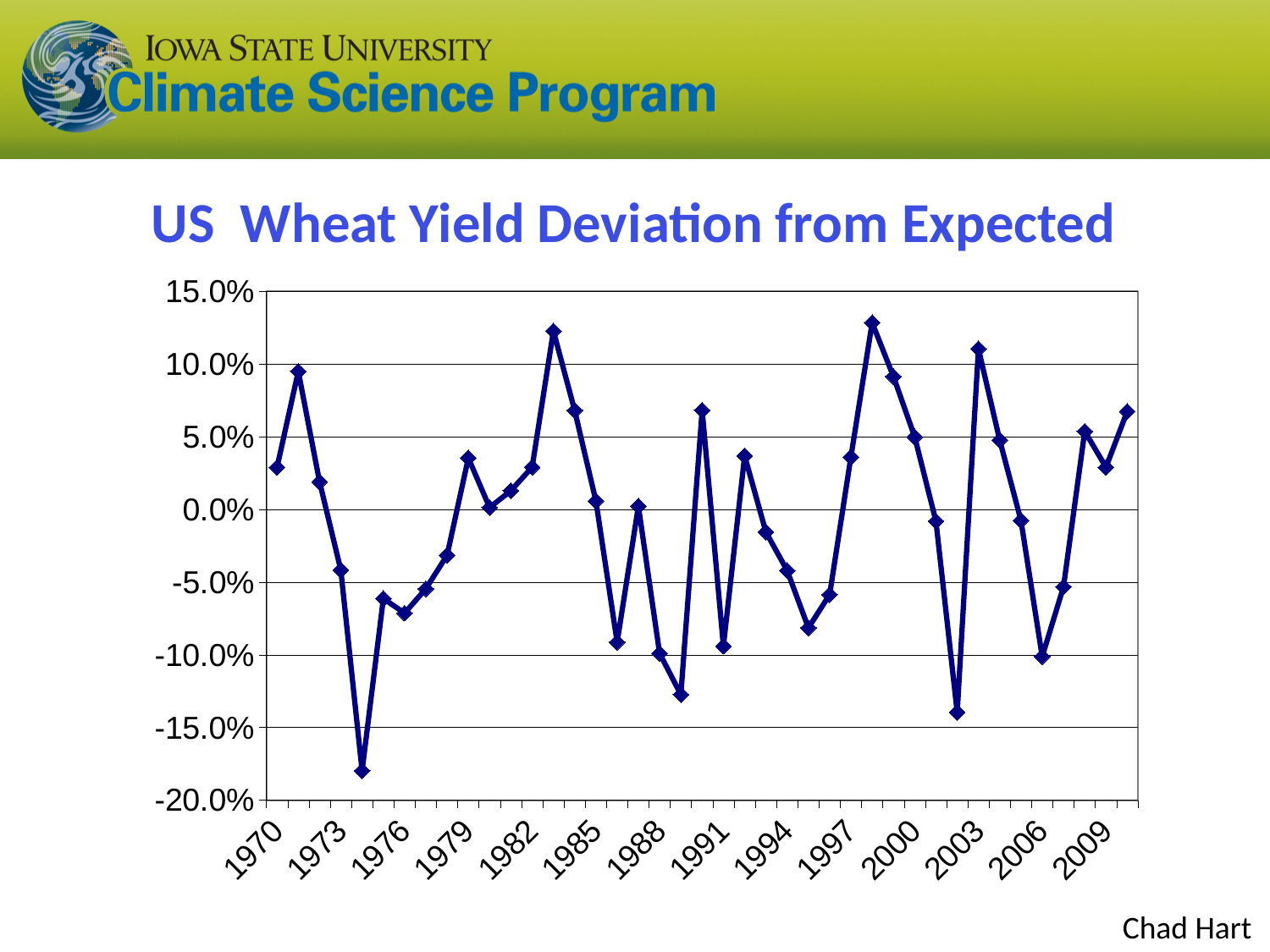
What kind of chart is shown on the slide? line chart Which is larger, the value for 1971 or the value for 1973? 1971 Which year has the lowest wheat yield deviation on the chart? 1974 What is the highest value shown on the vertical axis? 15.0% Is the value for 2002 greater or less than -10.0%? less Is the value for 2006 greater or less than -5.0%? less Does the line rise or fall from 1971 to 1974? fall Is the value for 1971 greater or less than 5.0%? greater Which is larger, the value for 1990 or the value for 1991? 1990 What is the title of the chart? US Wheat Yield Deviation from Expected